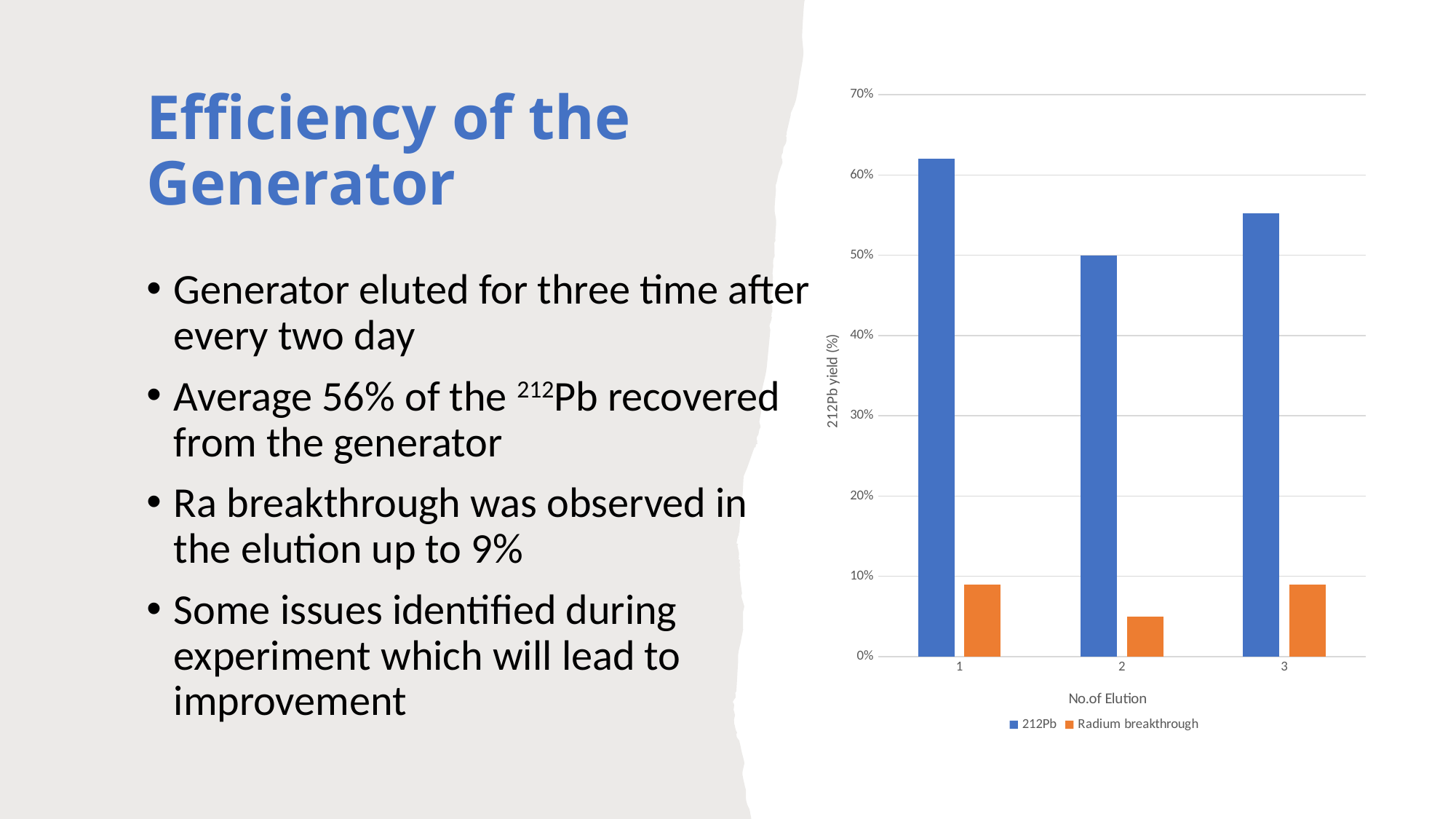
How many series does the chart legend list? 2 What kind of chart is shown on the slide? bar chart How many elutions are shown on the x axis of the chart? 3 Which elution has the lowest Radium breakthrough value? 2 What are the two series named in the chart legend? 212Pb and Radium breakthrough Is the 212Pb value for elution 3 greater or less than 60%? less Is the 212Pb value for elution 1 greater or less than 60%? greater Which elution has the lowest 212Pb value? 2 Which is larger, the 212Pb value for elution 1 or for elution 3? elution 1 Which elution has the highest 212Pb value? 1 What is the title of the x axis of the chart? No.of Elution Is the Radium breakthrough value for elution 2 greater or less than 10%? less